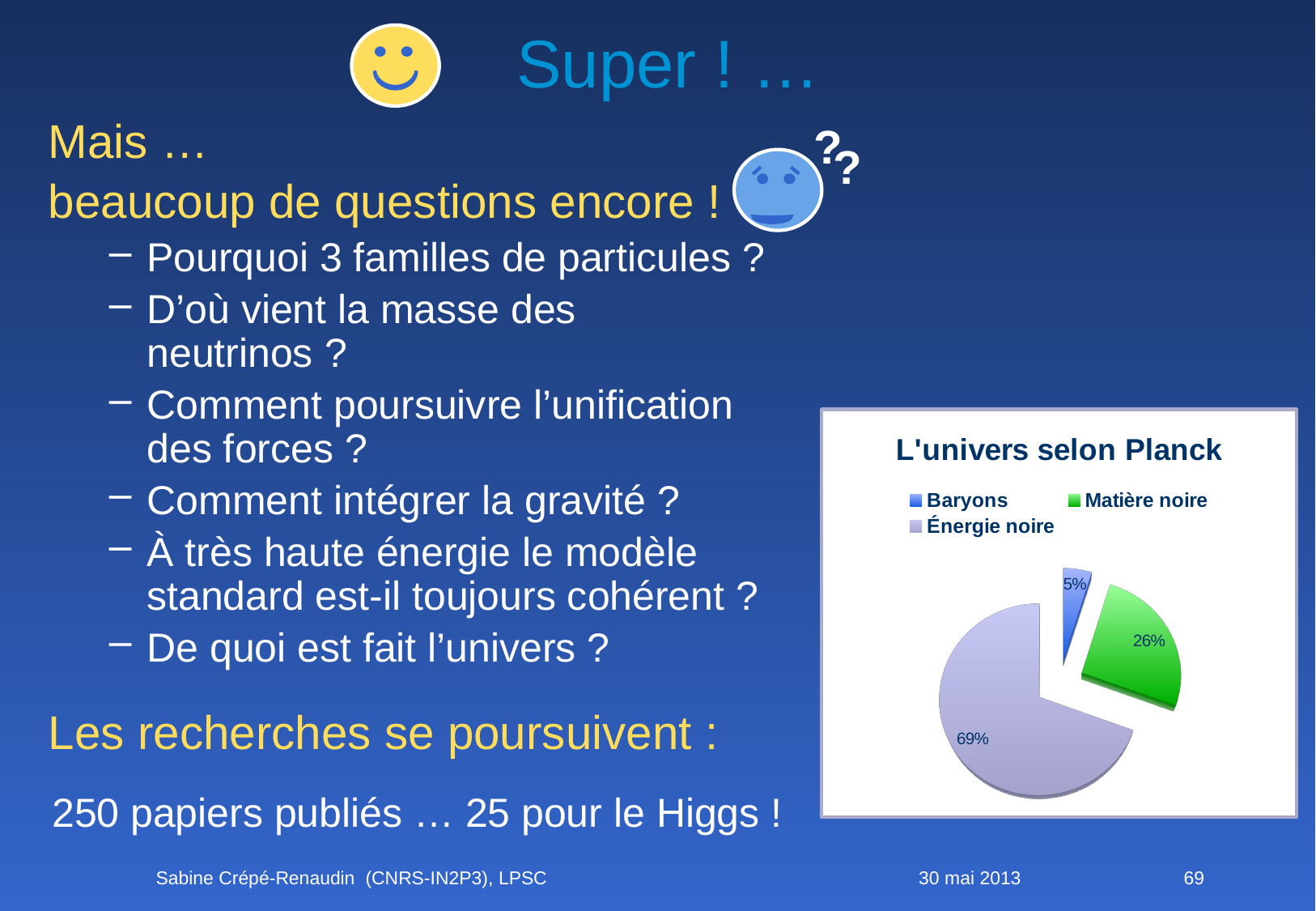
Which is larger, the slice for Matière noire or the slice for Baryons? Matière noire What is the title of the pie chart on the slide? L'univers selon Planck What colour is the Matière noire slice in the pie chart? green Which category has the smallest slice of the pie? Baryons What share of the pie does Énergie noire represent? 69% What share of the pie does Matière noire represent? 26% What type of chart is shown on the slide? pie chart What is the difference in percentage points between Matière noire and Baryons? 21 How many categories does the legend of the pie chart list? 3 What is the difference in percentage points between Énergie noire and Matière noire? 43 Which category has the largest slice of the pie? Énergie noire What share of the pie does Baryons represent? 5%